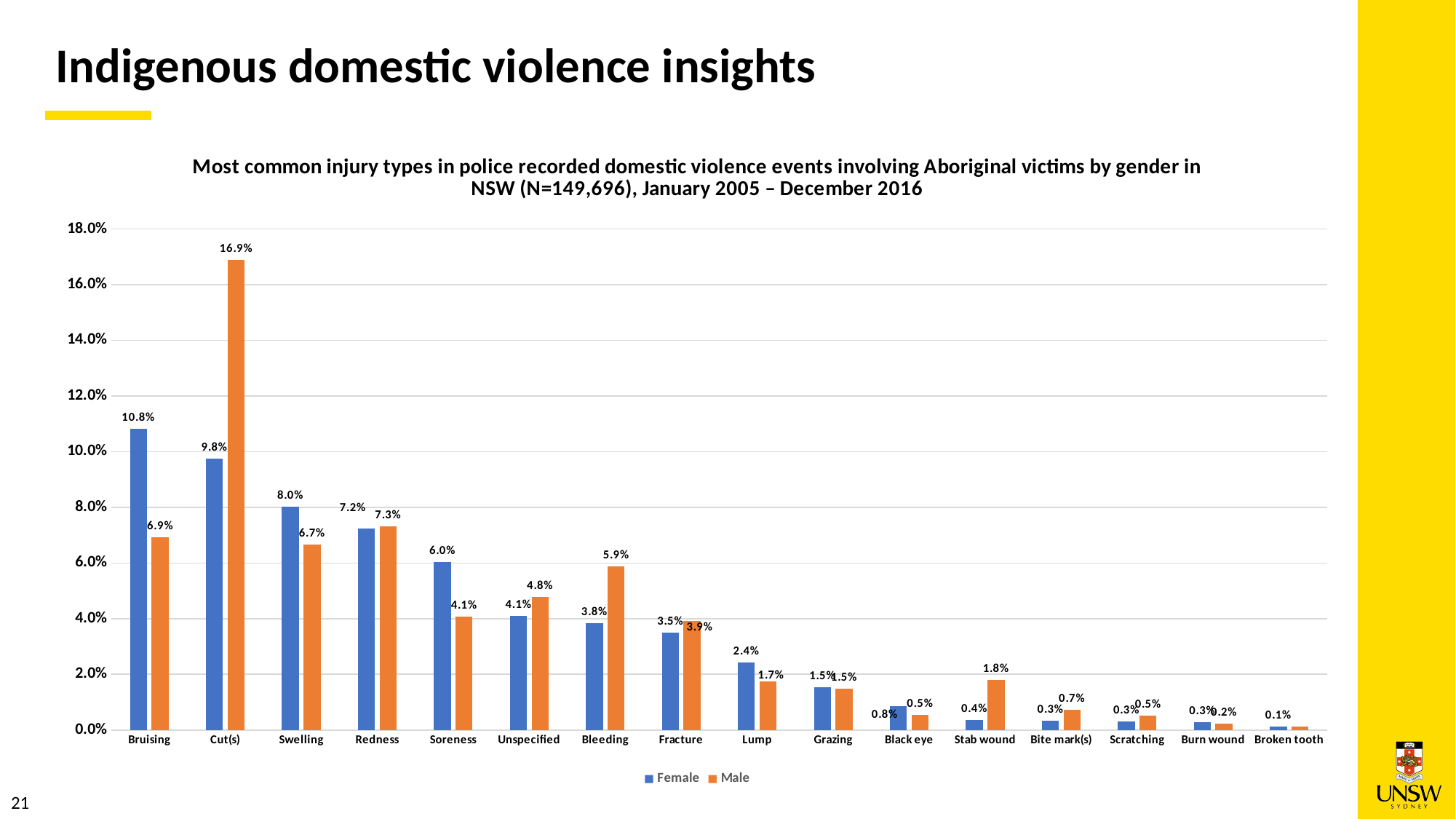
Is the Male value for Bleeding greater or less than 4.0%? greater For Stab wound, which is larger, the Female or the Male value? Male What is the Male value for Cut(s)? 16.9% What is the Female value for Bruising? 10.8% Which injury type has the highest Female value? Bruising What is the difference between the Female and Male values for Bruising? 3.9% How many series does the legend list? 2 What is the difference between the Male and Female values for Cut(s)? 7.1% How many injury types are shown on the x axis? 16 What kind of chart is shown on the slide? bar chart What is the Female value for Soreness? 6.0% Which injury type has the highest Male value? Cut(s)